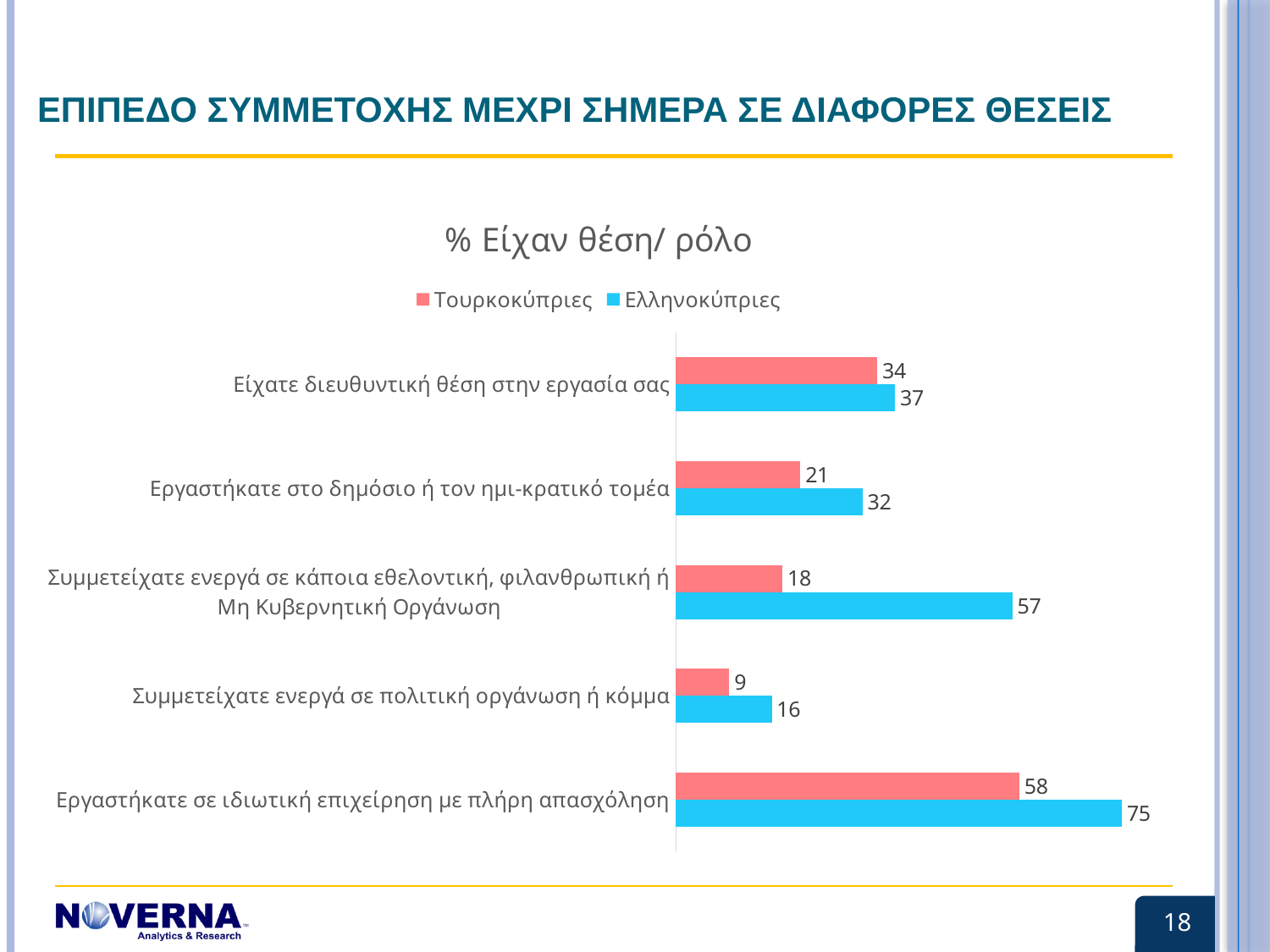
Which colour represents Τουρκοκύπριες in the chart? Red (pink) What is the difference between Ελληνοκύπριες and Τουρκοκύπριες for 'Συμμετείχατε ενεργά σε κάποια εθελοντική, φιλανθρωπική ή Μη Κυβερνητική Οργάνωση'? 39 How many series does the legend list? 2 For 'Είχατε διευθυντική θέση στην εργασία σας', which series has the larger value, Τουρκοκύπριες or Ελληνοκύπριες? Ελληνοκύπριες What kind of chart is shown on the slide? Bar chart Which category has the lowest value for Τουρκοκύπριες? Συμμετείχατε ενεργά σε πολιτική οργάνωση ή κόμμα What is the title of the chart? % Είχαν θέση/ ρόλο What is the value for Ελληνοκύπριες for 'Εργαστήκατε σε ιδιωτική επιχείρηση με πλήρη απασχόληση'? 75 Which category has the highest value for Ελληνοκύπριες? Εργαστήκατε σε ιδιωτική επιχείρηση με πλήρη απασχόληση What is the value for Τουρκοκύπριες for 'Εργαστήκατε στο δημόσιο ή τον ημι-κρατικό τομέα'? 21 How many categories are shown in the chart? 5 What is the value for Τουρκοκύπριες for 'Συμμετείχατε ενεργά σε πολιτική οργάνωση ή κόμμα'? 9